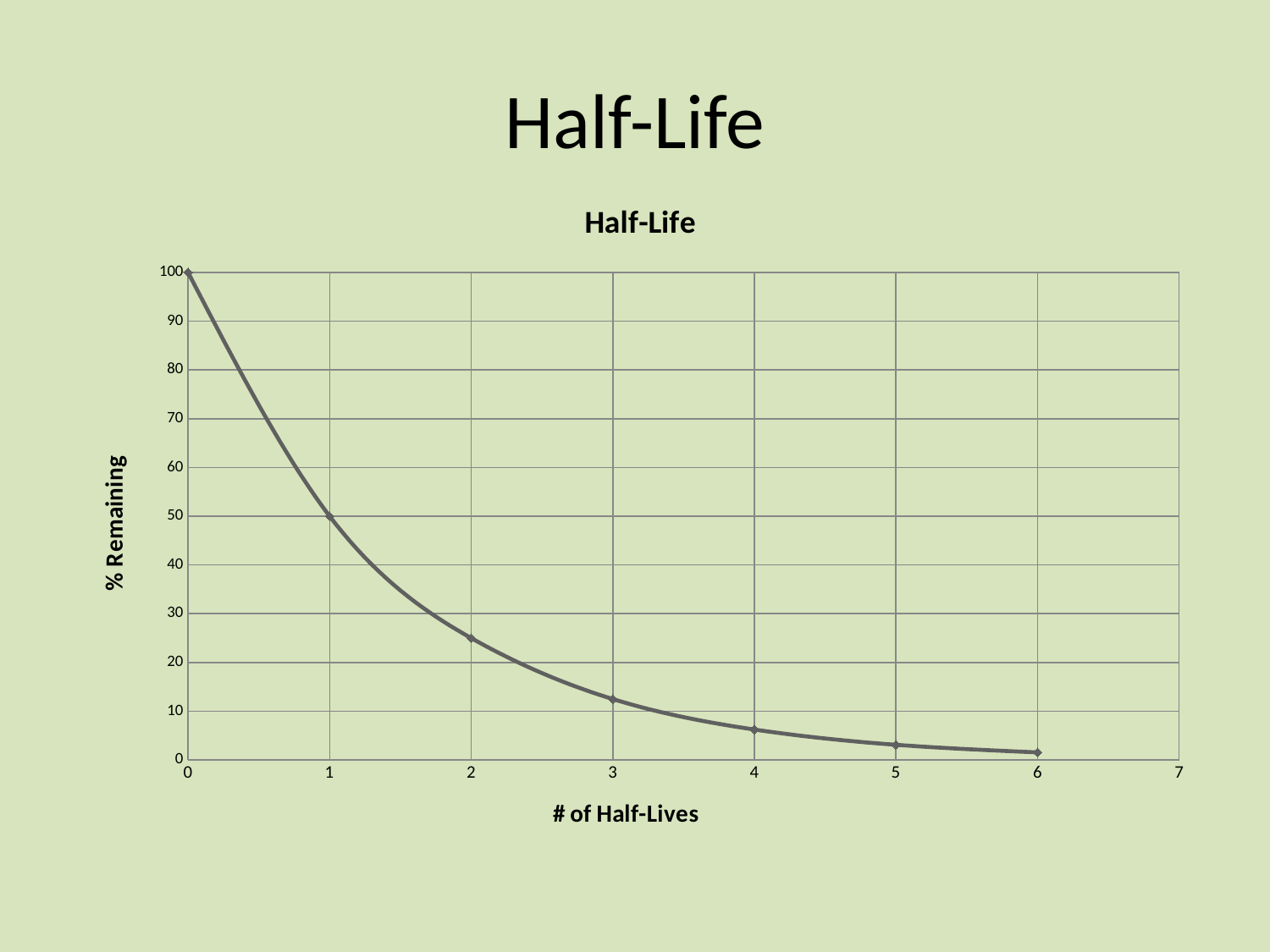
Is the % Remaining at 3 half-lives greater or less than 20? less Is the % Remaining at 2 half-lives greater or less than 20? greater What is the % Remaining at 0 half-lives? 100 Does the % Remaining rise or fall as the number of half-lives increases? fall Is the % Remaining at 4 half-lives greater or less than 10? less Which has a higher % Remaining: 1 half-life or 3 half-lives? 1 half-life What kind of chart is shown on the slide? line chart At which number of half-lives is the % Remaining highest? 0 How many data points are plotted on the chart? 7 What is the % Remaining at 1 half-life? 50 At which number of half-lives is the % Remaining lowest? 6